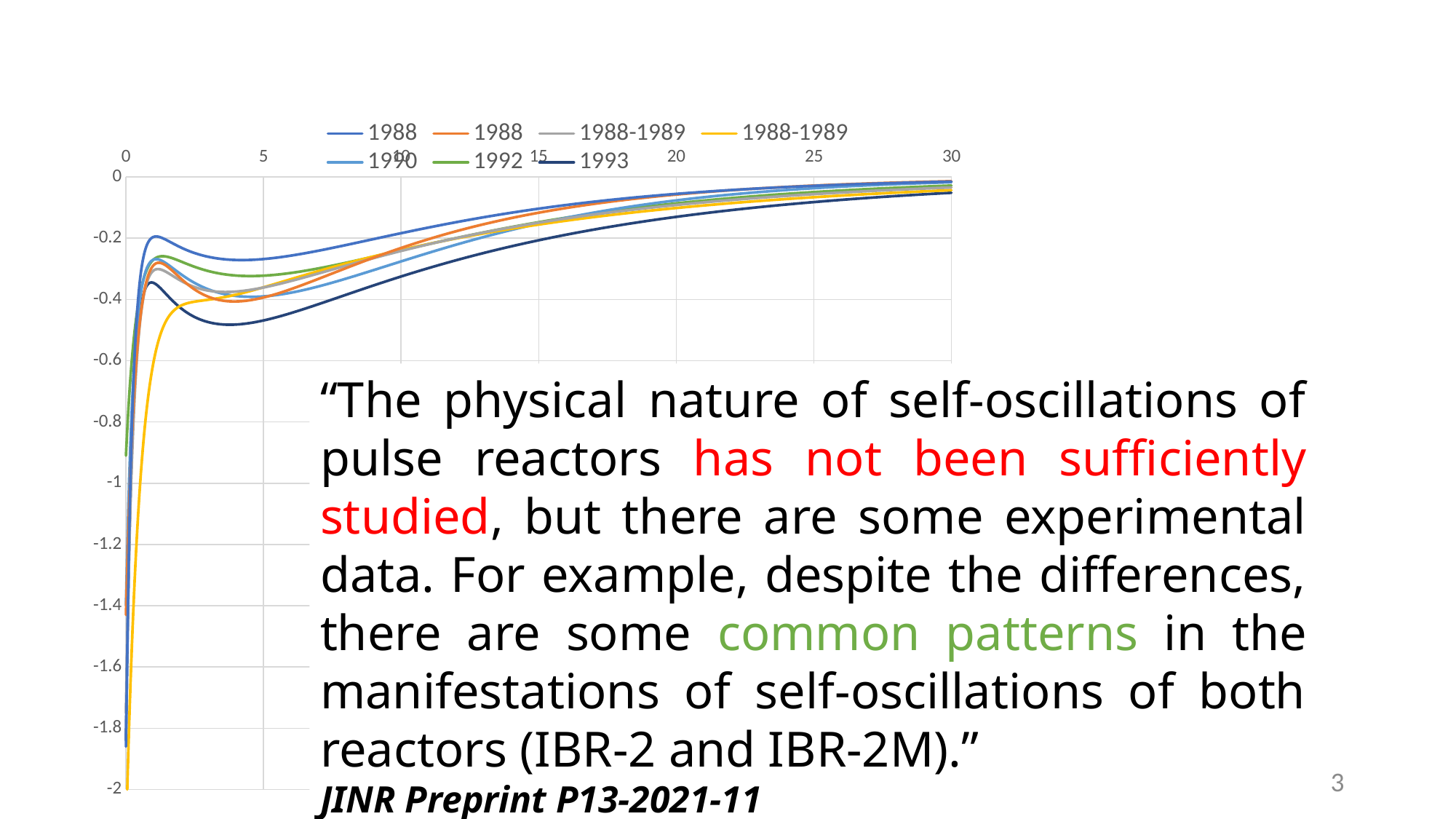
Between x = 10 and x = 30, do the plotted series rise or fall along the x axis? rise How many tick labels are shown on the x axis of the chart? 7 Around x = 5, which series has the lowest value? 1993 What kind of chart is shown on the slide? line chart What is the lowest value labelled on the y axis of the chart? -2 How many series does the chart's legend list? 7 Is the value of the 1993 series at x = 5 greater or less than -0.4? less Is the value of the 1993 series at x = 30 greater or less than -0.2? greater What is the highest value labelled on the x axis of the chart? 30